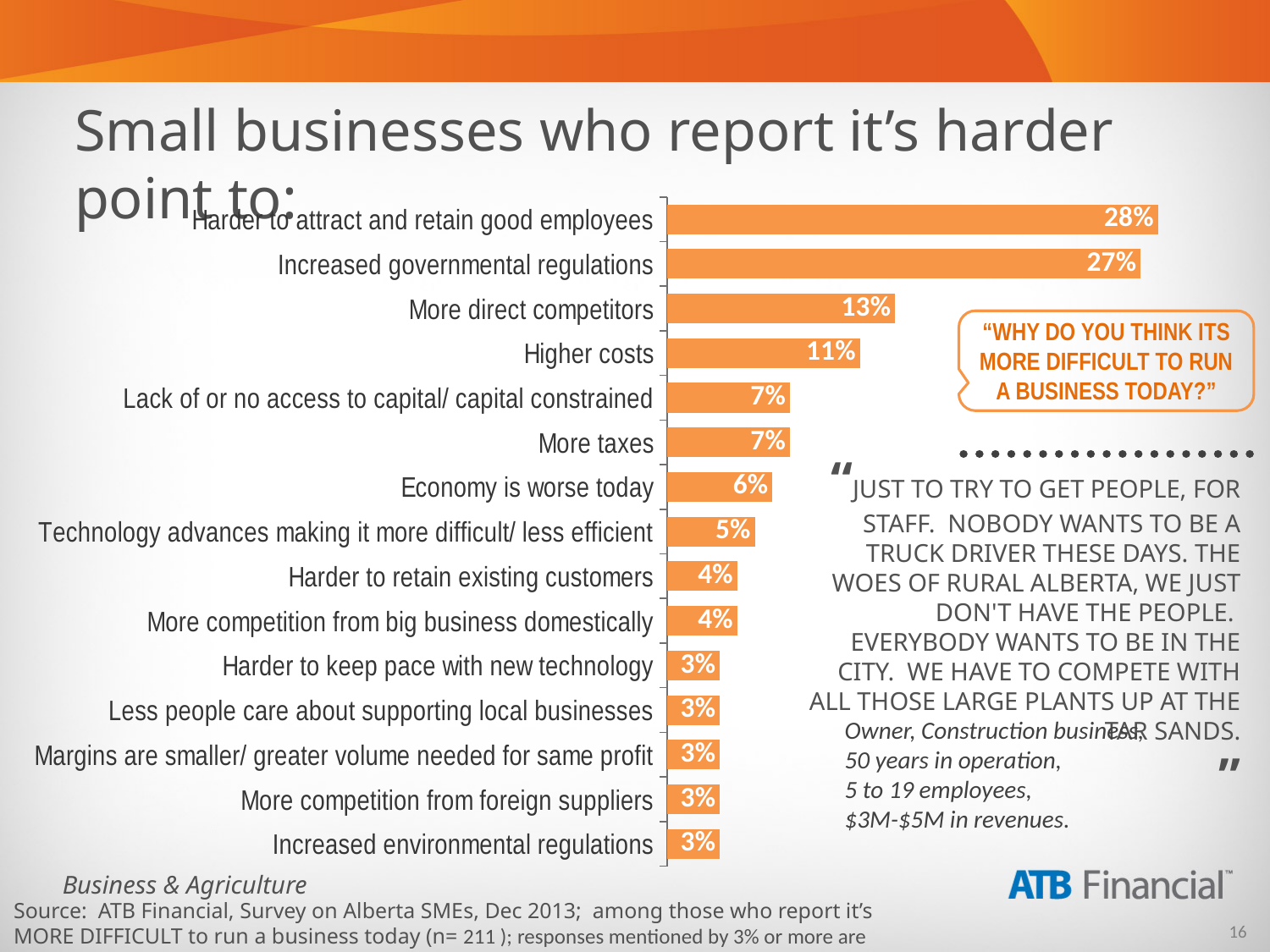
What is the lowest percentage value shown in the chart? 3% What percentage of small businesses point to 'Harder to attract and retain good employees'? 28% Which category has the highest percentage in the chart? Harder to attract and retain good employees What kind of chart is shown on the slide? Bar chart What colour are the bars in the chart? Orange Which is larger: 'More direct competitors' or 'Higher costs'? More direct competitors How many categories are shown in the chart? 15 What is the value shown for 'Increased governmental regulations'? 27% What is the difference between 'More direct competitors' and 'Higher costs'? 2 percentage points What is the difference between 'Harder to attract and retain good employees' and 'Increased governmental regulations'? 1 percentage point What percentage is shown for 'Higher costs'? 11% What is the value for 'Economy is worse today'? 6%